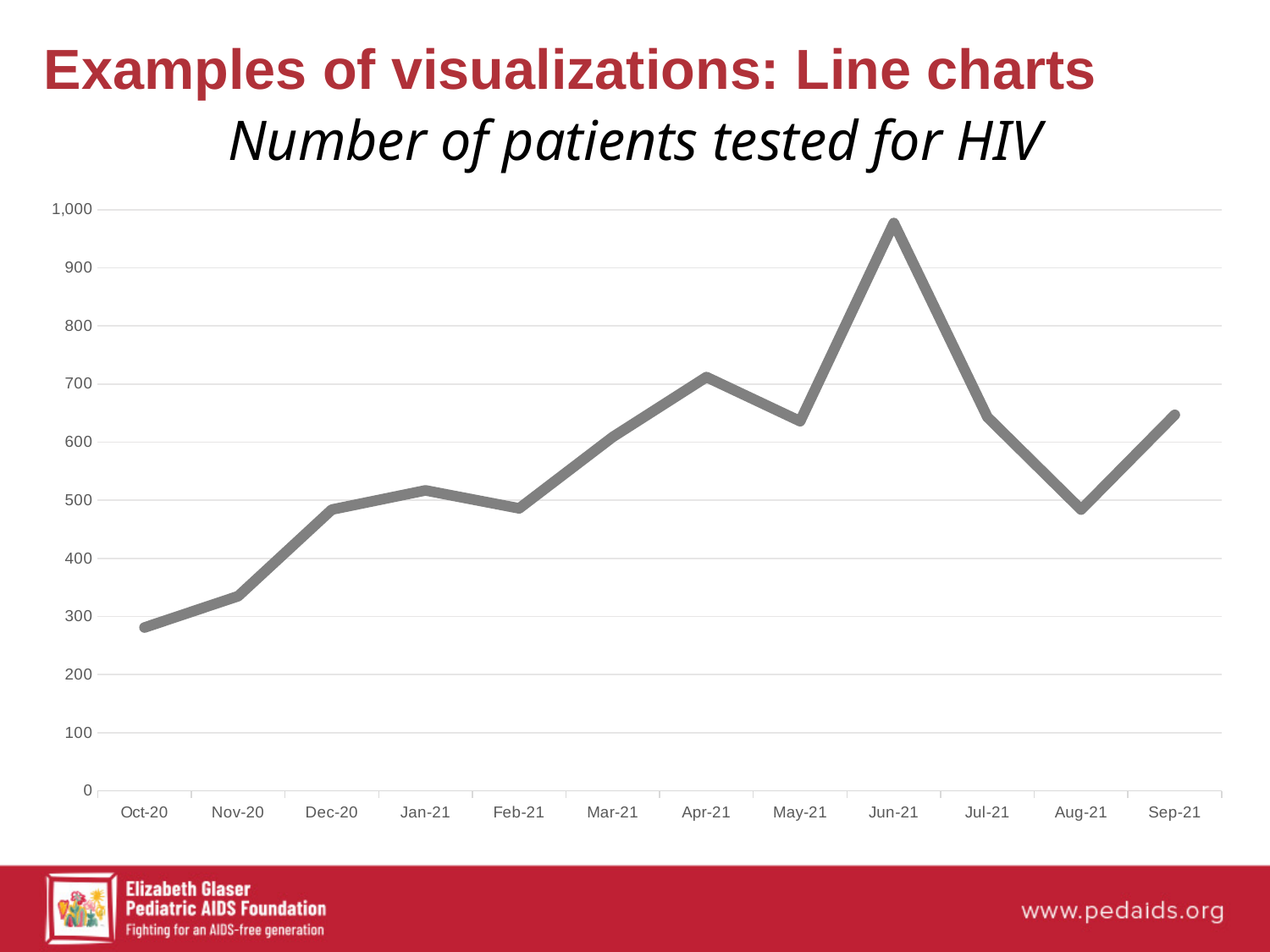
Which month has the lowest number of patients tested for HIV? Oct-20 Is the value for Mar-21 greater or less than 500? greater Do the values rise or fall from Jun-21 to Aug-21? Fall Is the value for Jun-21 greater or less than 900? greater Is the value for Oct-20 greater or less than 300? less What is the title of the chart? Number of patients tested for HIV How many months are plotted on the x axis? 12 Which is larger, the value for Nov-20 or the value for Dec-20? Dec-20 Which is larger, the value for Apr-21 or the value for Jun-21? Jun-21 What type of chart is shown on the slide? Line chart Which month has the highest number of patients tested for HIV? Jun-21